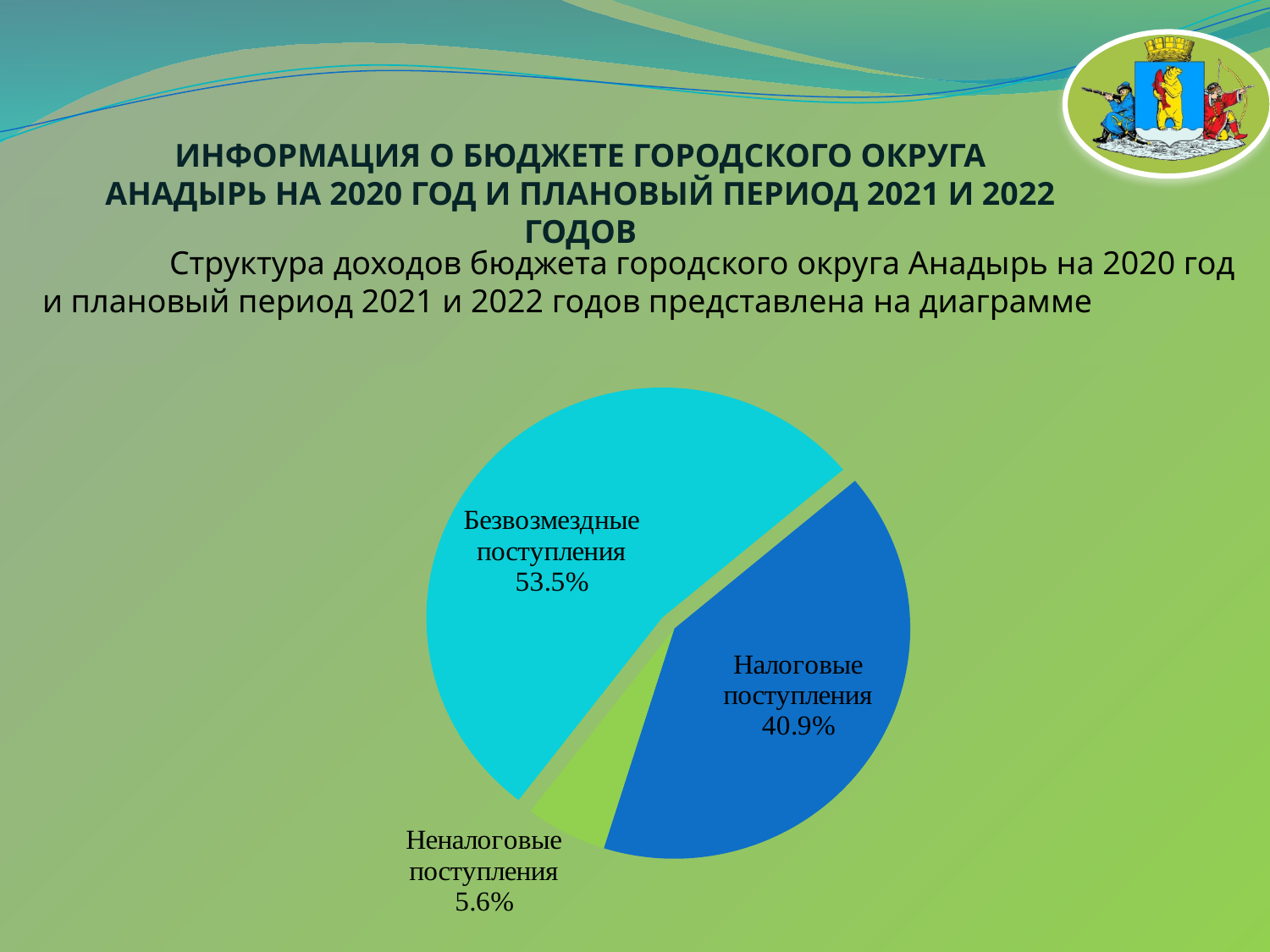
What is the difference between the shares of Безвозмездные поступления and Налоговые поступления? 12.6% What share of the pie is Безвозмездные поступления? 53.5% What share of the pie is Налоговые поступления? 40.9% Which category has the largest share of the pie? Безвозмездные поступления What share of the pie is Неналоговые поступления? 5.6% Which is larger: the share of Налоговые поступления or Неналоговые поступления? Налоговые поступления What is the difference between the shares of Налоговые поступления and Неналоговые поступления? 35.3% How many categories does the pie chart show? 3 What colour is the slice for Неналоговые поступления? Green What colour is the slice for Налоговые поступления? Blue What kind of chart is shown on the slide? Pie chart Which category has the smallest share of the pie? Неналоговые поступления